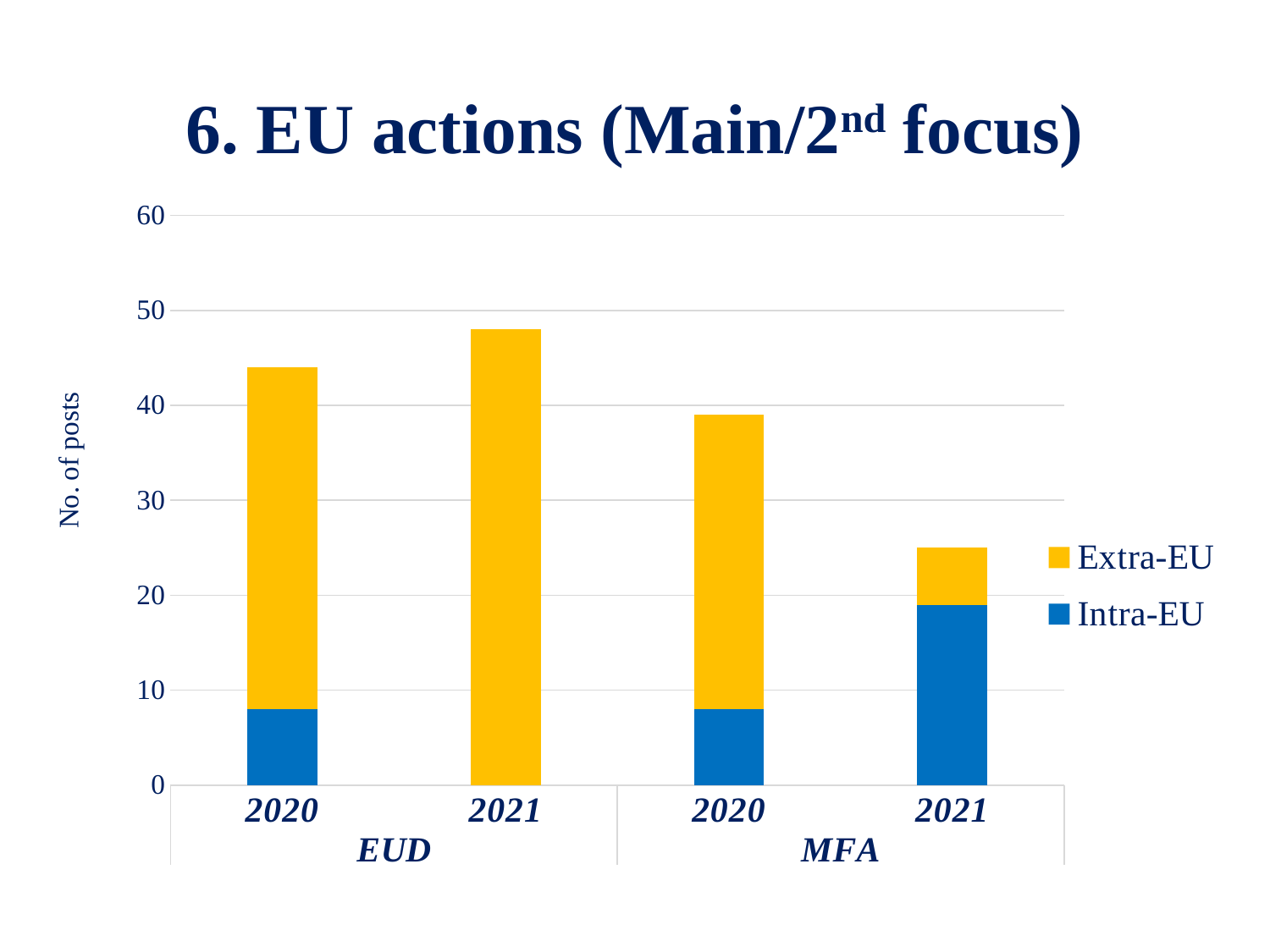
Is the Intra-EU value for MFA 2021 greater or less than 10? greater What is the label on the vertical axis? No. of posts Which has the larger total, EUD 2020 or MFA 2020? EUD 2020 Which bar is the tallest overall? EUD 2021 Which bar is the shortest overall? MFA 2021 Is the total for EUD 2020 greater or less than 40? greater What kind of chart is shown on the slide? Stacked bar chart Is the total for EUD 2021 greater or less than 40? greater How many series does the legend list? 2 Which has the larger Intra-EU value, MFA 2020 or MFA 2021? MFA 2021 How many bars are plotted in the chart? 4